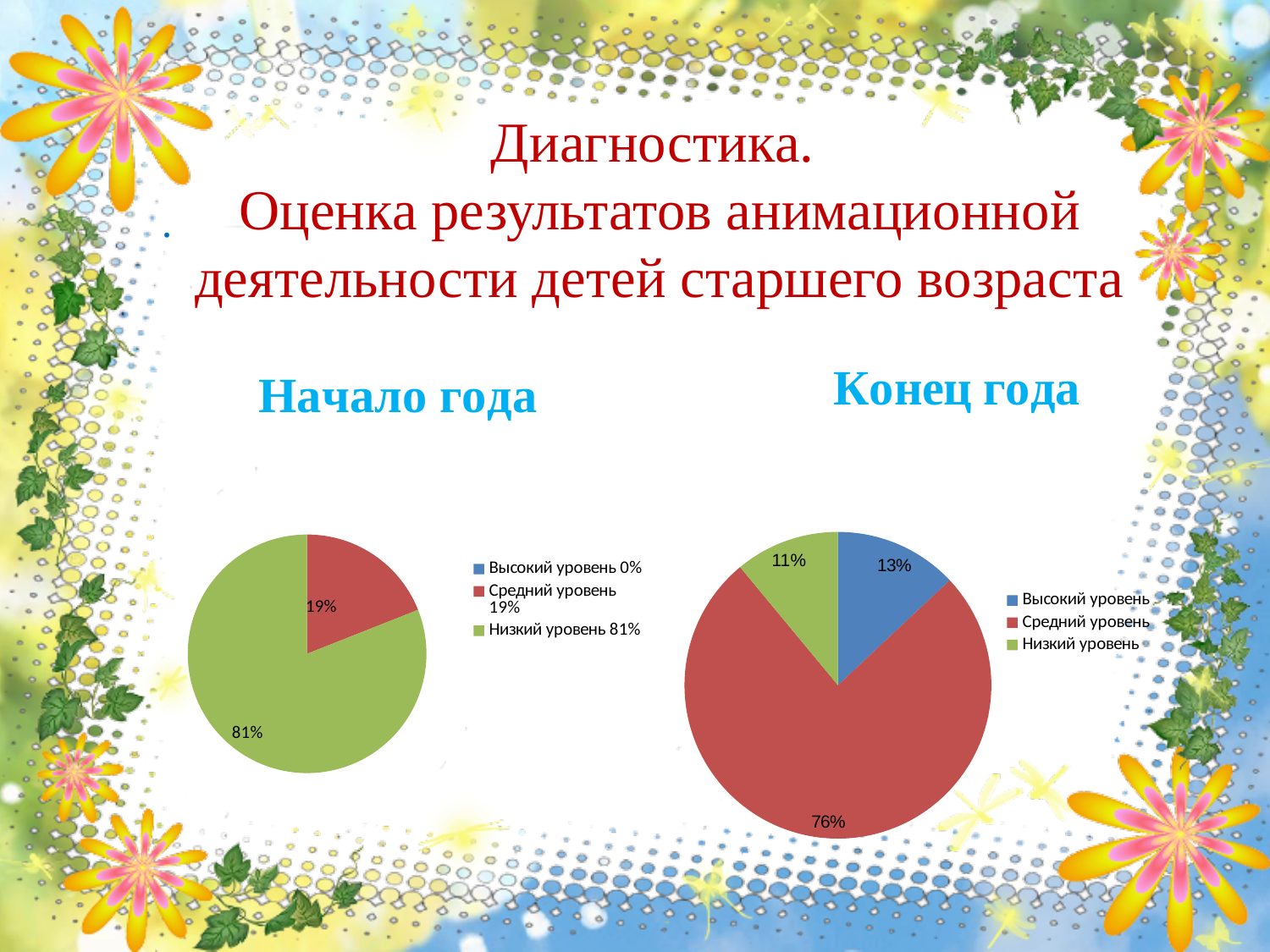
In the "Конец года" chart, what share is "Низкий уровень"? 11% In the "Конец года" chart, what share is "Средний уровень"? 76% Which is larger: "Высокий уровень" in the "Конец года" chart or "Низкий уровень" in the "Конец года" chart? Высокий уровень In the "Начало года" chart, what share is "Средний уровень"? 19% In the "Начало года" chart, which level has the smallest slice? Высокий уровень In the "Начало года" chart, what share is "Низкий уровень"? 81% What type of chart is used for "Начало года"? pie chart What is the difference between "Низкий уровень" in the "Начало года" chart and "Низкий уровень" in the "Конец года" chart? 70% In the "Конец года" chart, what share is "Высокий уровень"? 13% In the "Начало года" chart, what share is "Высокий уровень"? 0% How many entries does the legend of the "Конец года" chart list? 3 In the "Конец года" chart, which level has the largest slice? Средний уровень